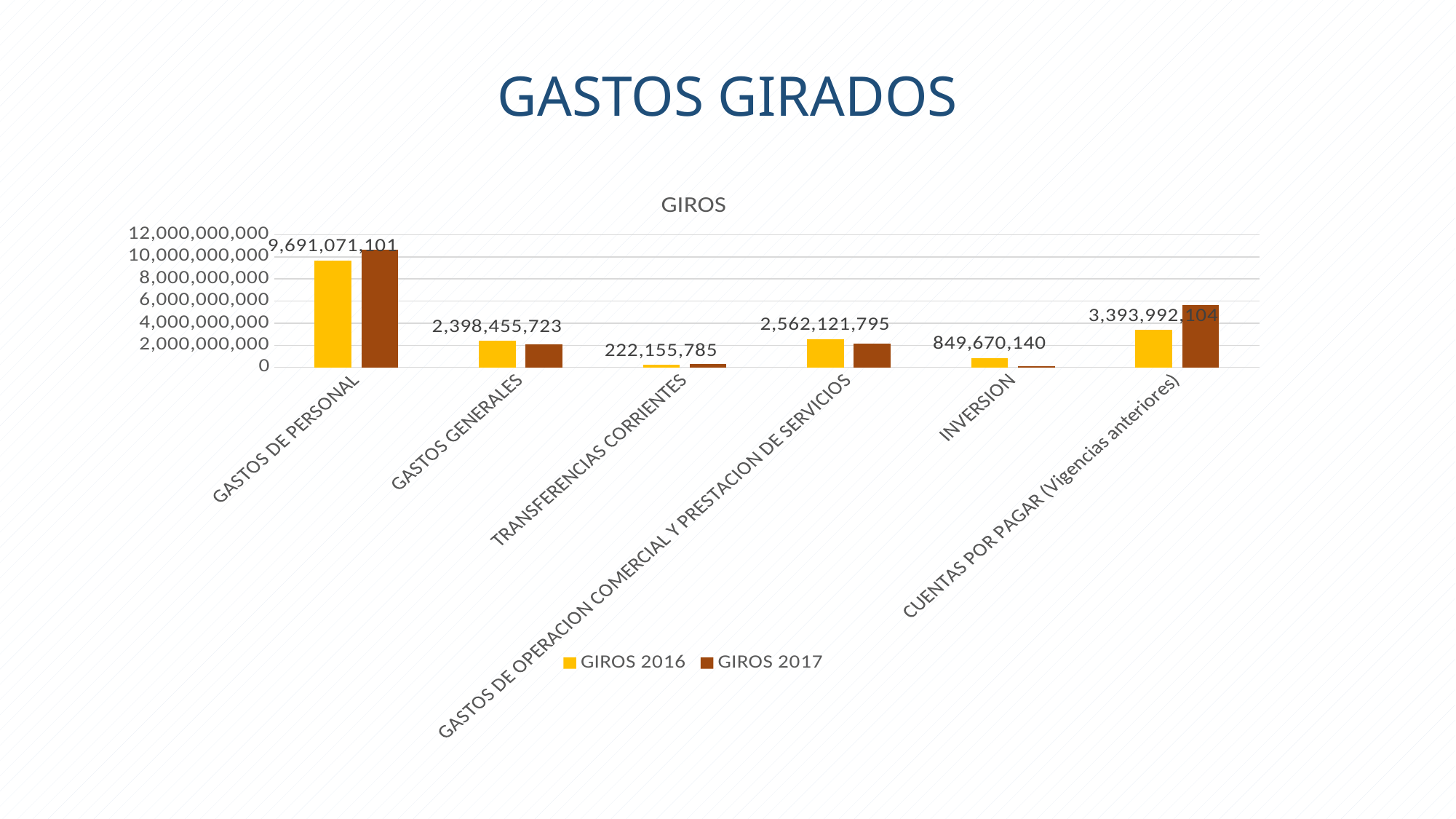
What is the difference between the GIROS 2016 values for GASTOS DE OPERACION COMERCIAL Y PRESTACION DE SERVICIOS and GASTOS GENERALES? 163,666,072 For INVERSION, which series has the larger value, GIROS 2016 or GIROS 2017? GIROS 2016 How many series does the legend list? 2 What is the GIROS 2016 value for GASTOS DE PERSONAL? 9,691,071,101 How many categories are shown on the x axis of the chart? 6 Which category has the lowest GIROS 2016 value? TRANSFERENCIAS CORRIENTES Is the GIROS 2017 value for CUENTAS POR PAGAR (Vigencias anteriores) greater or less than 4,000,000,000? greater What type of chart is shown on the slide? bar chart What is the GIROS 2016 value for INVERSION? 849,670,140 Which category has the highest GIROS 2016 value? GASTOS DE PERSONAL What is the GIROS 2016 value for GASTOS GENERALES? 2,398,455,723 What is the GIROS 2016 value for TRANSFERENCIAS CORRIENTES? 222,155,785